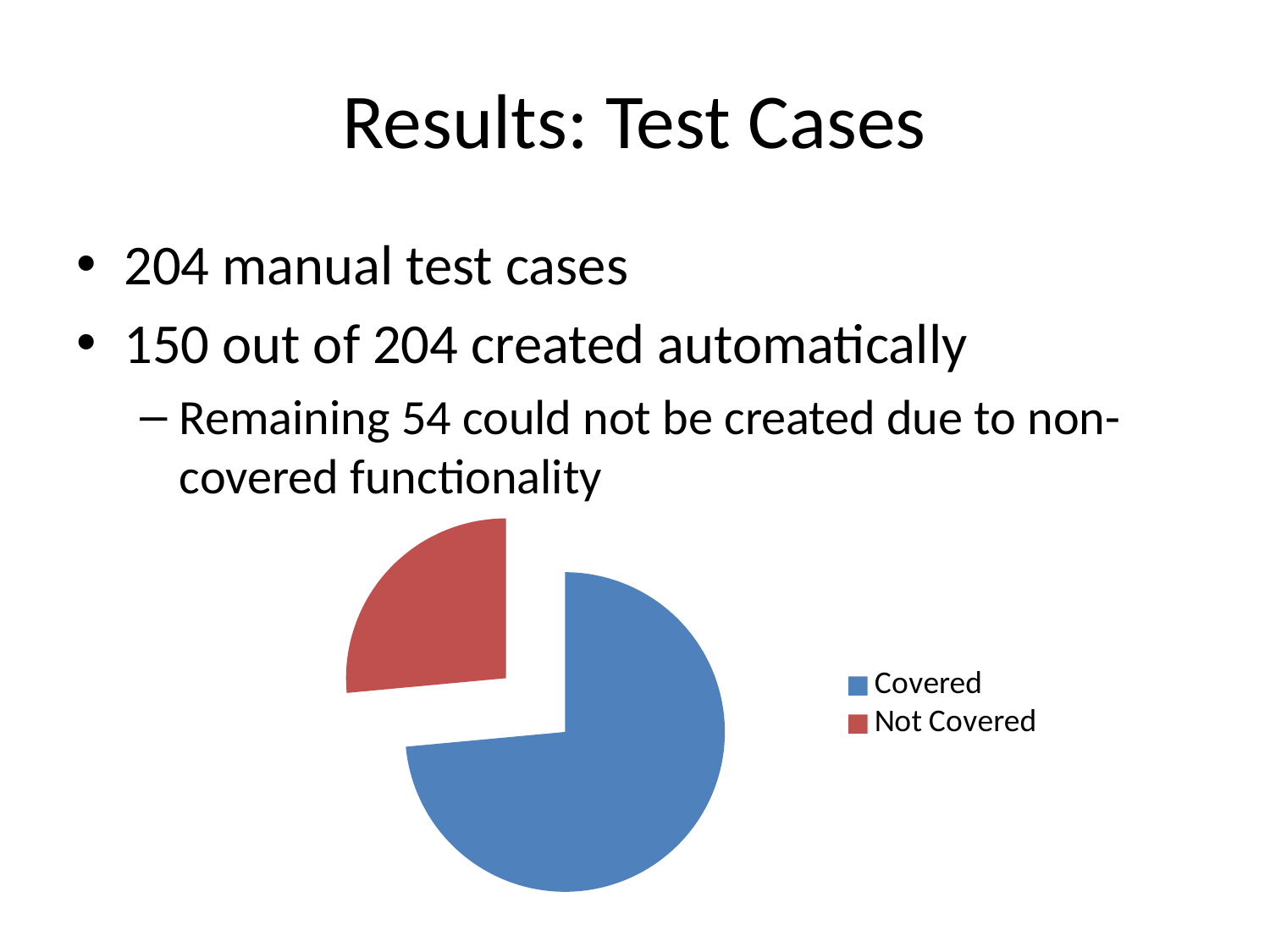
Which slice of the pie chart is the smallest? Not Covered What kind of chart is shown on the slide? pie chart How many entries does the legend of the pie chart list? 2 What colour is the Covered slice in the pie chart? blue Which slice of the pie chart is the largest? Covered Which slice of the pie chart is pulled out (exploded) from the rest of the pie? Not Covered How many slices does the pie chart have? 2 Which slice is larger in the pie chart, Covered or Not Covered? Covered